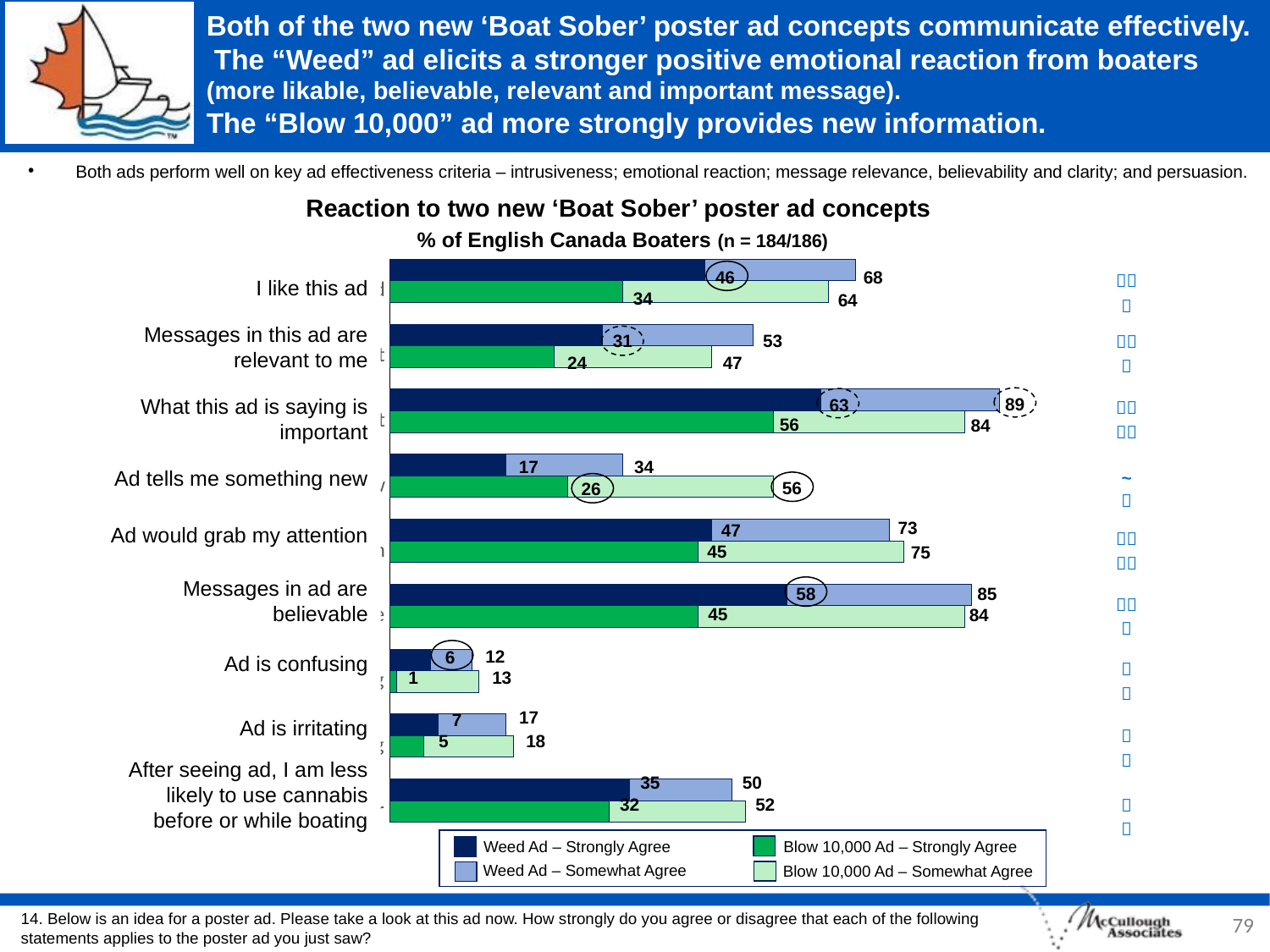
How many statements (categories) are plotted in the chart? 9 What type of chart is shown on the slide? bar chart Which statement has the lowest strongly agree percentage for the Blow 10,000 Ad? Ad is confusing Which statement has the highest total agree percentage for the Weed Ad? What this ad is saying is important What percentage of boaters strongly agree with 'What this ad is saying is important' for the Weed Ad? 63 What is the total agree percentage (strongly plus somewhat) for the Blow 10,000 Ad on 'Ad tells me something new'? 56 What sample size is shown in the chart subtitle? n = 184/186 For 'Ad tells me something new', how many percentage points higher is the Blow 10,000 Ad total agree than the Weed Ad total agree? 22 For 'I like this ad', what is the difference between the Weed Ad strongly agree and the Blow 10,000 Ad strongly agree percentages? 12 What is the title of the chart? Reaction to two new 'Boat Sober' poster ad concepts For 'Ad would grab my attention', which ad has the higher total agree percentage? Blow 10,000 Ad How many series does the legend list? 4